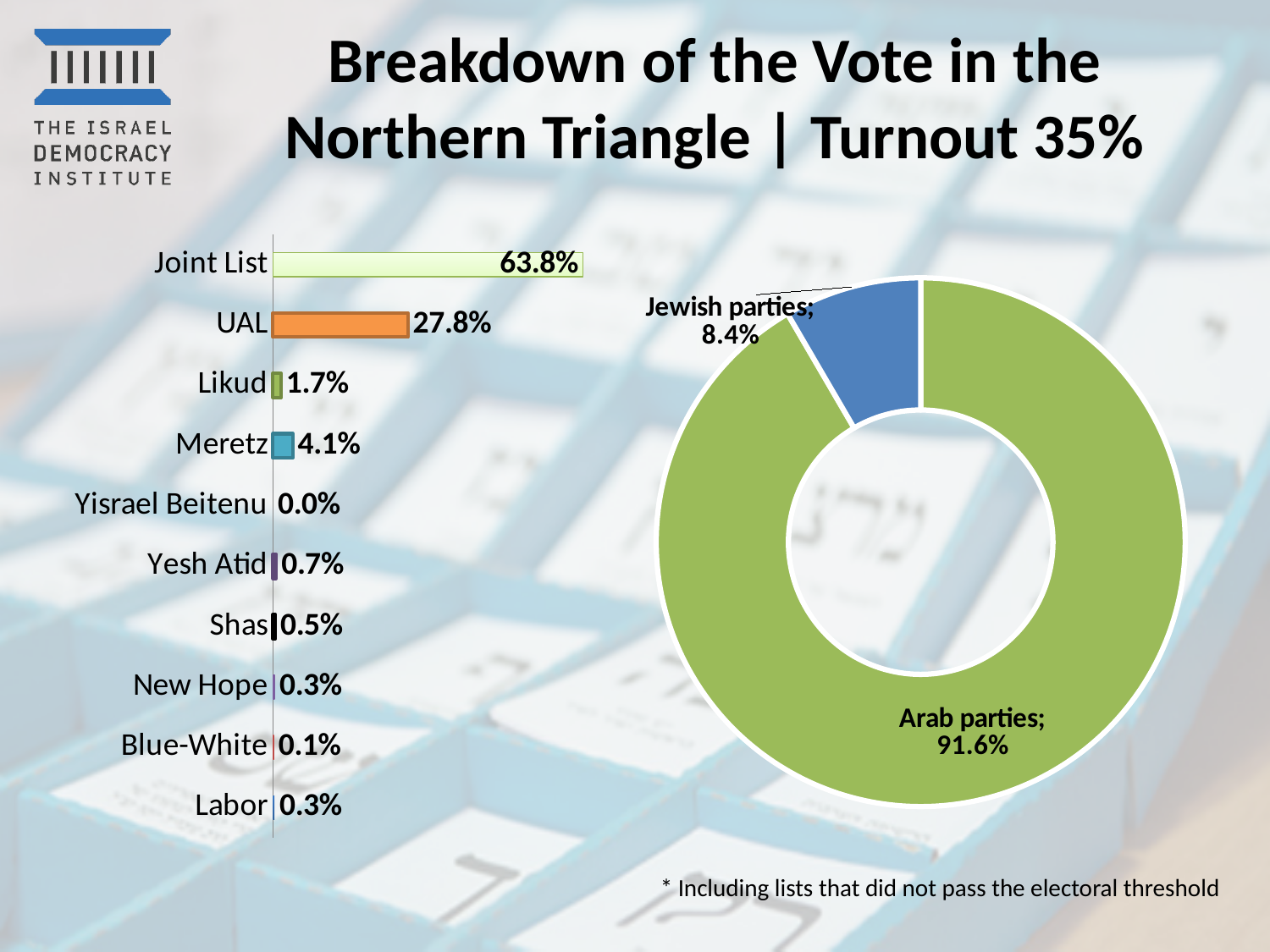
In the bar chart on the left, which party has the lowest value? Yisrael Beitenu What kind of chart is shown on the left of the slide? Bar chart In the bar chart on the left, what is the value for Joint List? 63.8% In the doughnut chart on the right, what share do Jewish parties have? 8.4% How many parties are listed in the bar chart on the left? 10 What is the turnout stated in the slide title? 35% In the bar chart on the left, what is the difference between the values for Joint List and UAL? 36.0% In the bar chart on the left, which is larger, the value for Likud or the value for Meretz? Meretz In the bar chart on the left, what is the value for UAL? 27.8% In the bar chart on the left, what is the value for Meretz? 4.1% In the bar chart on the left, which party has the highest value? Joint List In the doughnut chart on the right, what share do Arab parties have? 91.6%